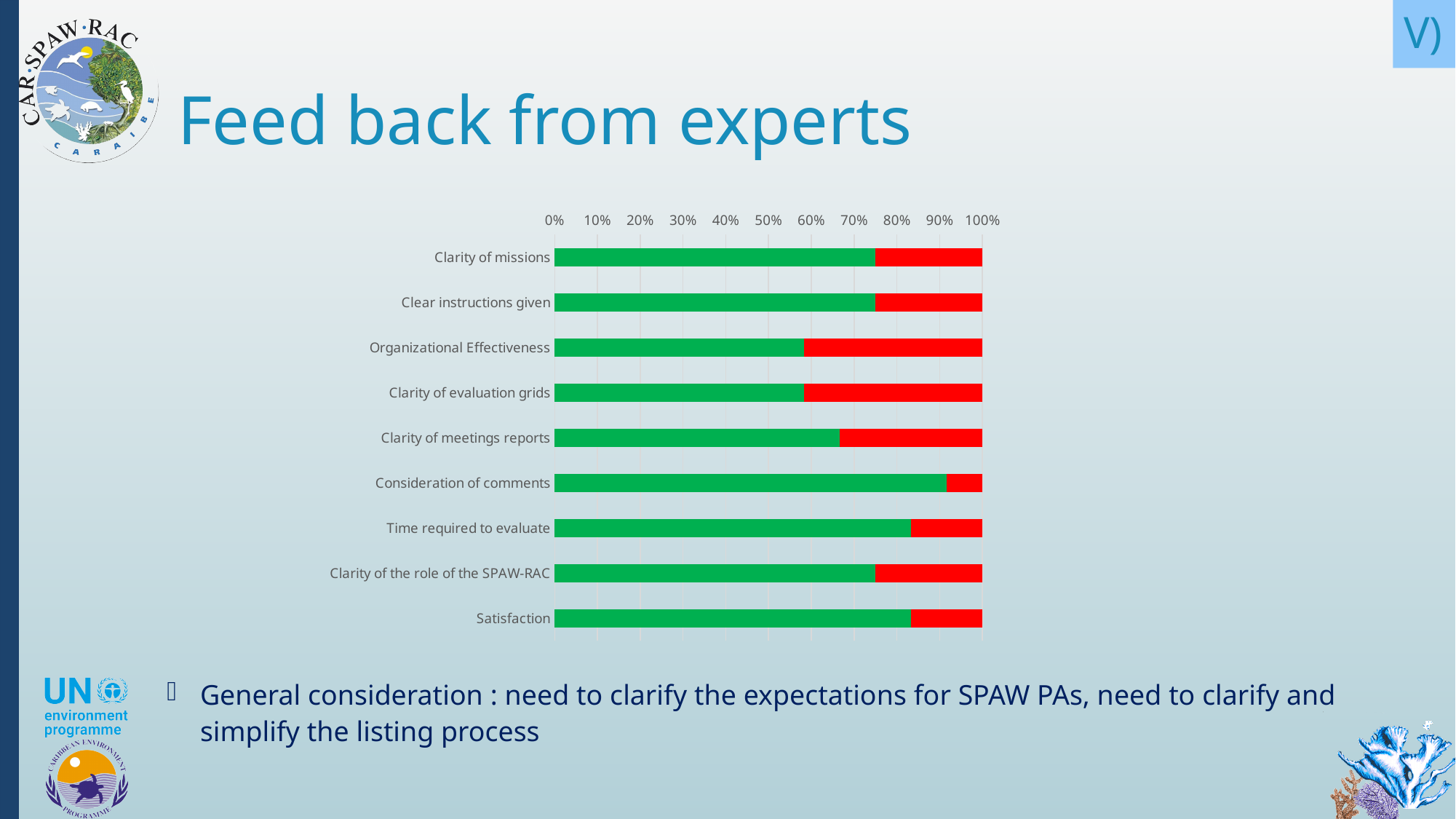
Is the green segment for Consideration of comments greater or less than 90%? greater Which category has the largest green segment? Consideration of comments Is the green segment for Clarity of missions greater or less than 70%? greater Is the green segment for Satisfaction greater or less than 80%? greater What two colours are used for the bar segments in the chart? Green and red How many categories are plotted on the chart? 9 What is the title of the slide containing the chart? Feed back from experts Which has the larger green segment, Consideration of comments or Clarity of meetings reports? Consideration of comments What value does each full stacked bar reach on the axis? 100% What kind of chart is shown on the slide? Stacked bar chart